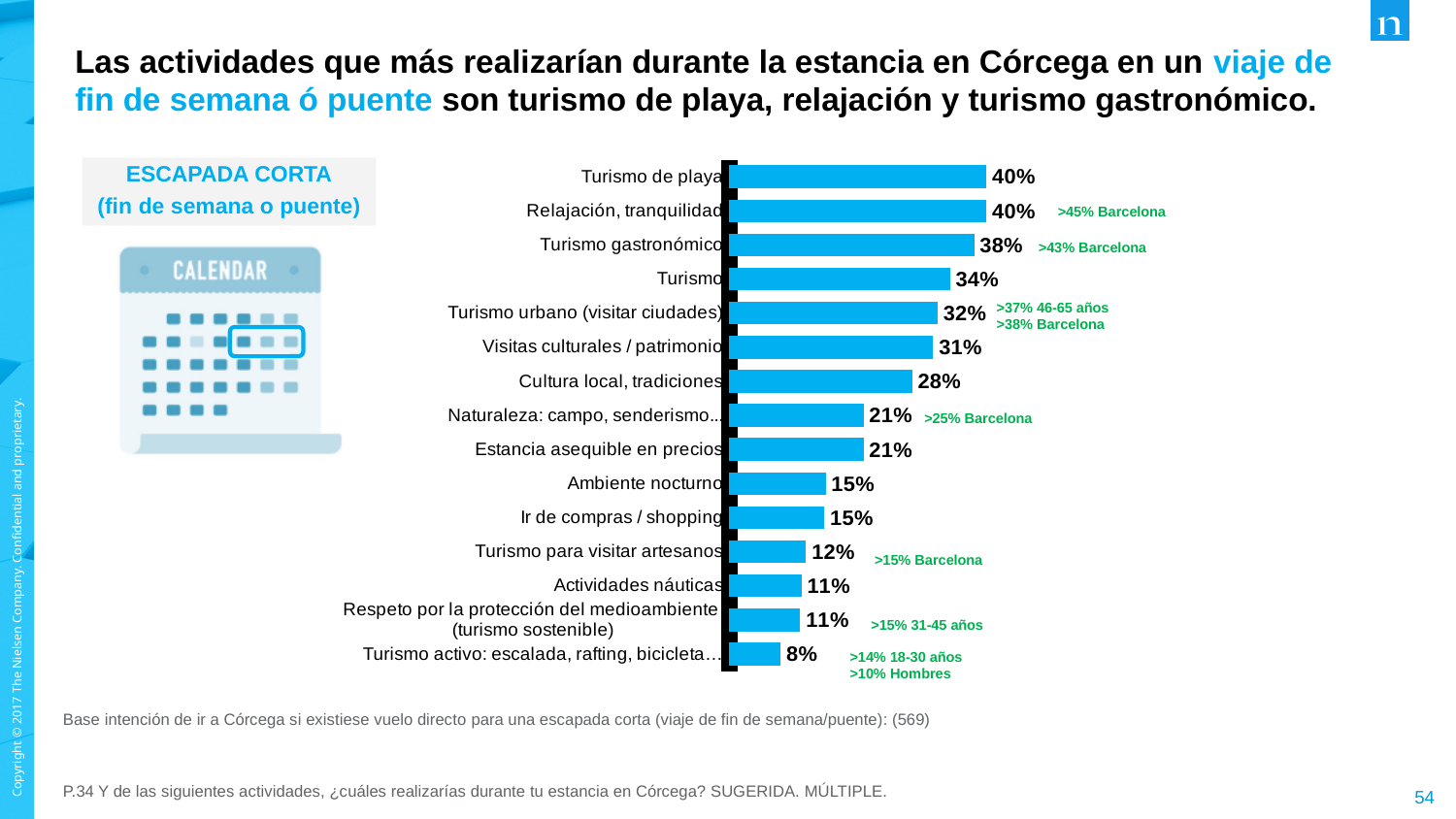
What is the value for Relajación, tranquilidad? 40% Which is larger, the value for Turismo para visitar artesanos or the value for Ir de compras / shopping? Ir de compras / shopping How many categories are shown in the chart? 15 Which category has the lowest value? Turismo activo: escalada, rafting, bicicleta… What kind of chart is shown on the slide? Bar chart What is the value for Cultura local, tradiciones? 28% Which is larger, the value for Turismo or the value for Cultura local, tradiciones? Turismo What is the difference between the values for Turismo de playa and Turismo urbano (visitar ciudades)? 8% What is the difference between the values for Visitas culturales / patrimonio and Estancia asequible en precios? 10% What is the value for Turismo gastronómico? 38% What is the value for Ambiente nocturno? 15% What is the value for Actividades náuticas? 11%